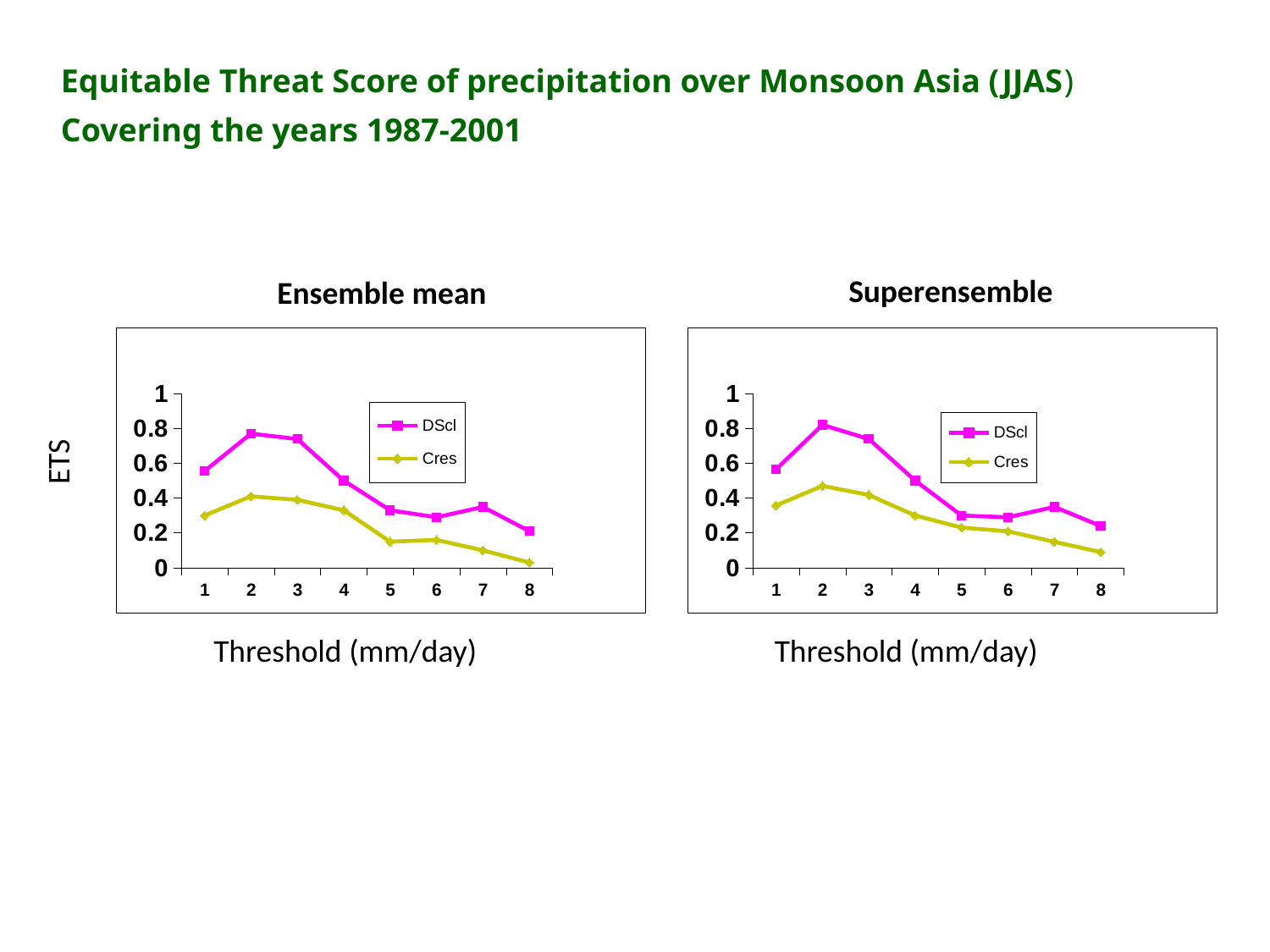
How many series does the legend of the Superensemble chart list? 2 In the Superensemble chart, which series has the larger value at threshold 1, DScl or Cres? DScl In the Superensemble chart, at which threshold does the DScl series reach its highest value? 2 In the Ensemble mean chart, is the Cres value at threshold 5 greater or less than 0.2? less In the Ensemble mean chart, is the DScl value at threshold 1 greater or less than 0.4? greater How many threshold values are plotted along the x axis of the Ensemble mean chart? 8 In the Superensemble chart, is the DScl value at threshold 2 greater or less than 0.6? greater In the Superensemble chart, at which threshold does the Cres series reach its lowest value? 8 What type of chart is the Ensemble mean chart? line chart In the Ensemble mean chart, does the Cres series generally rise or fall from threshold 3 to threshold 8? fall What is the label on the x axis of the Superensemble chart? Threshold (mm/day) In the Ensemble mean chart, at which threshold does the Cres series reach its lowest value? 8